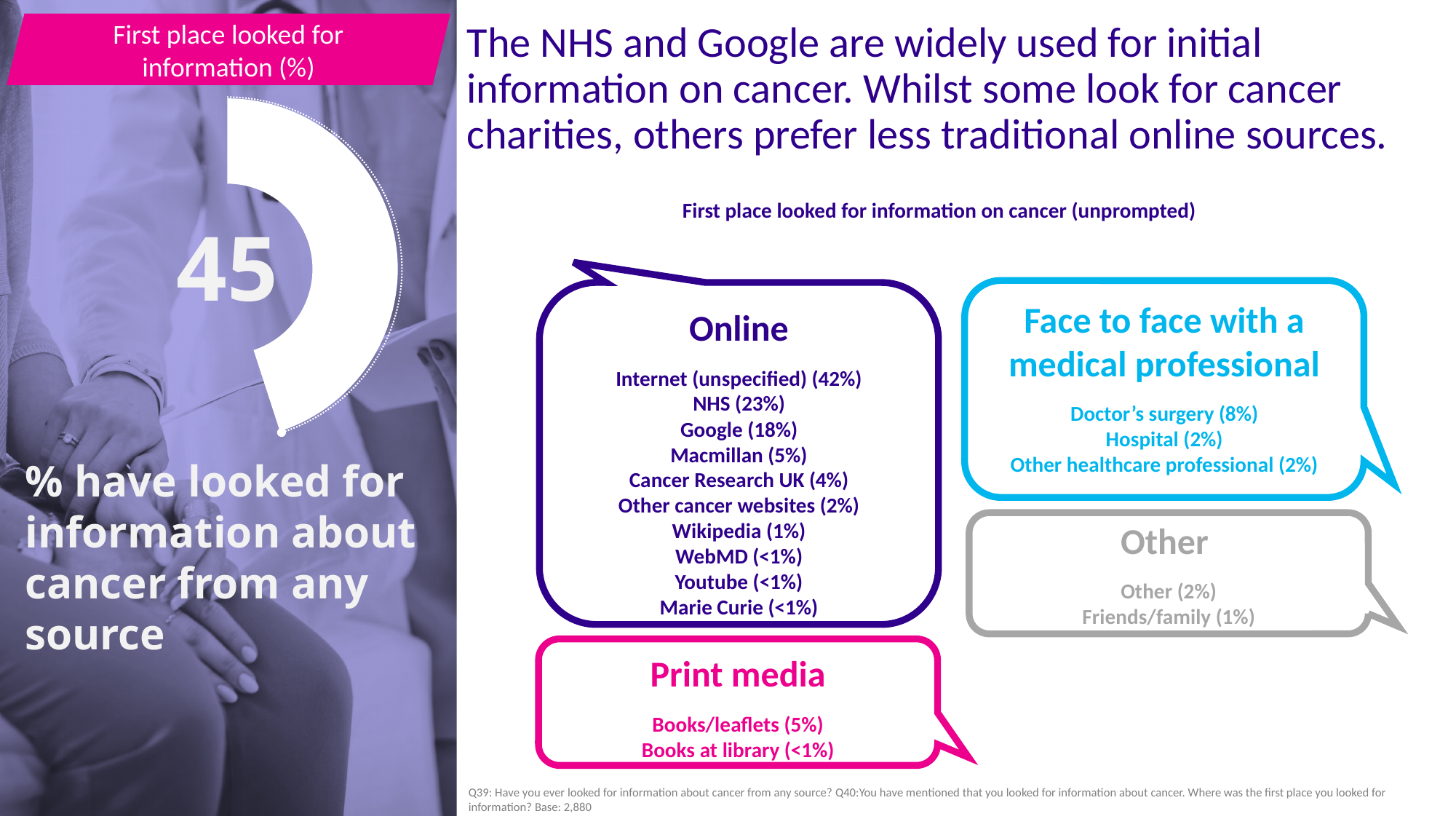
In the 'Face to face with a medical professional' box, what percentage is given for Doctor's surgery? 8% What value is printed in the centre of the doughnut chart on the left of the slide? 45 What kind of chart is shown on the left of the slide under the heading 'First place looked for information (%)'? Doughnut chart In the 'Online' box, which source has the highest percentage? Internet (unspecified) According to the doughnut chart on the left, what percentage have looked for information about cancer from any source? 45 What is the difference between the NHS percentage (23%) and the Google percentage (18%) in the 'Online' box? 5% Is the value shown in the doughnut chart on the left greater or less than 40? greater In the 'Online' box on the right of the slide, what percentage is given for Google? 18% What colour is the filled segment of the doughnut chart on the left of the slide? White Is the value shown in the doughnut chart on the left greater or less than 50? less In the 'Online' box on the right of the slide, what percentage is given for NHS? 23% What is the heading printed in the pink banner above the doughnut chart on the left? First place looked for information (%)